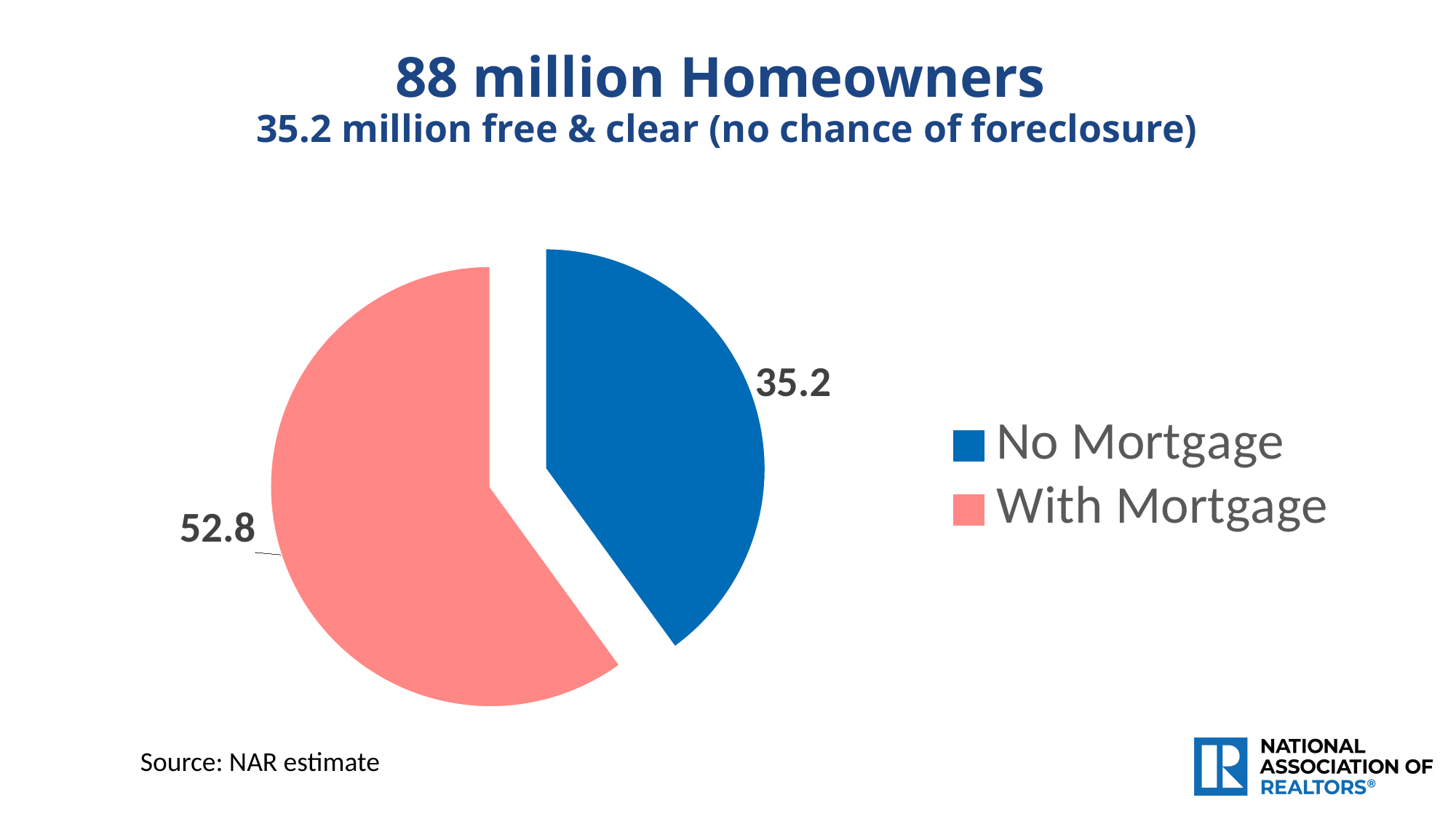
How many slices does the pie chart have? 2 What is the difference between the With Mortgage and No Mortgage values? 17.6 Which category has the largest slice of the pie? With Mortgage Which category has the smallest slice of the pie? No Mortgage Which is larger, No Mortgage or With Mortgage? With Mortgage What is the value for With Mortgage? 52.8 What share of the pie does the No Mortgage slice represent? 40% What colour is the With Mortgage slice? Pink What is the total of the two slices in the pie chart? 88 What kind of chart is shown on the slide? Pie chart What is the value for No Mortgage? 35.2 How many entries does the legend list? 2